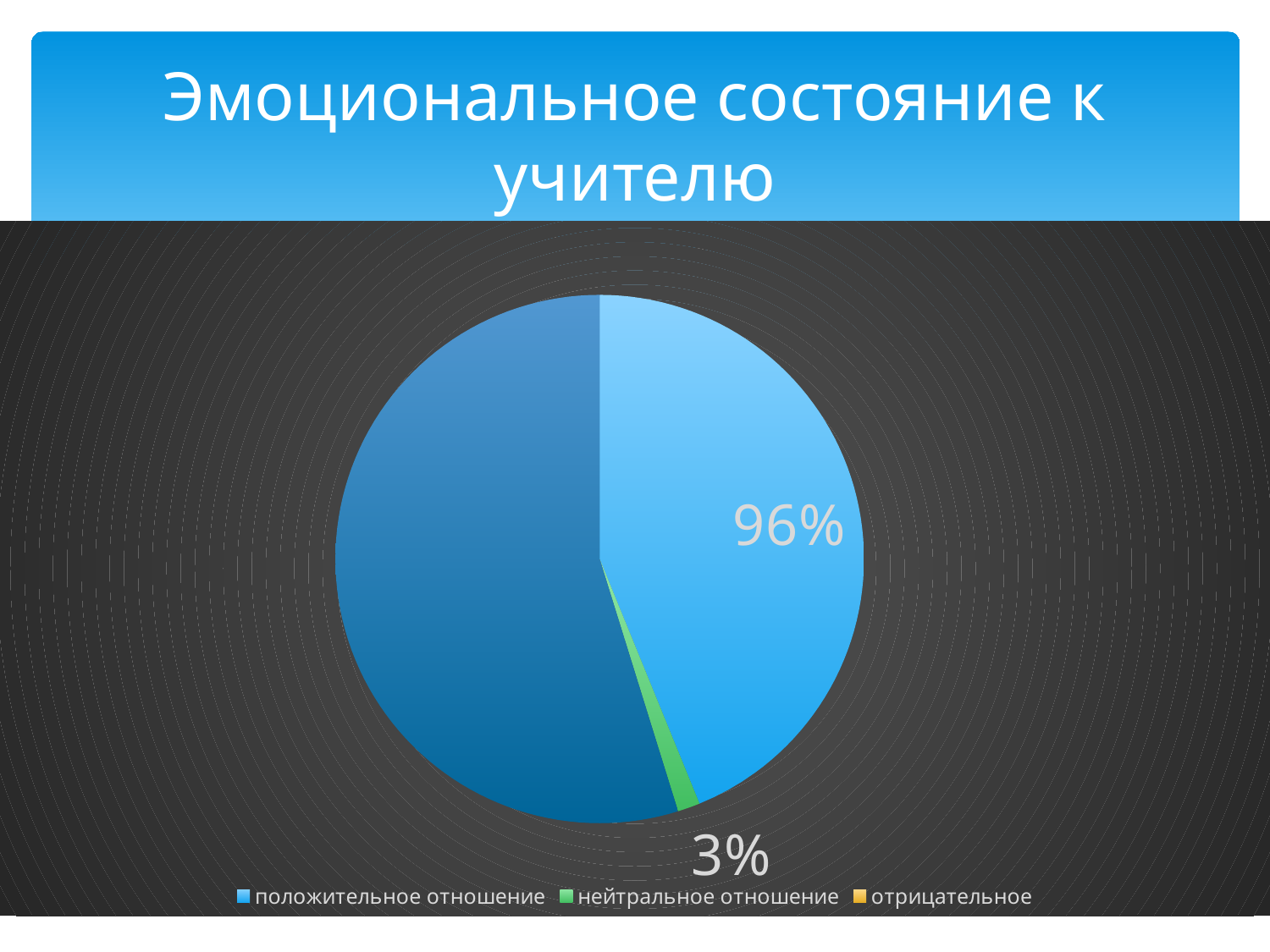
What share of the pie does 'положительное отношение' take? 96% Which is larger, the slice for 'положительное отношение' or the slice for 'нейтральное отношение'? положительное отношение Which category has the largest slice of the pie? положительное отношение Is the share for 'положительное отношение' greater or less than 50%? greater What is the title of the chart? Эмоциональное состояние к учителю By how many percentage points does 'положительное отношение' exceed 'нейтральное отношение'? 93 What kind of chart is shown on the slide? pie chart What share of the pie does 'нейтральное отношение' take? 3% What colour represents 'нейтральное отношение' in the legend? green How many categories does the legend list? 3